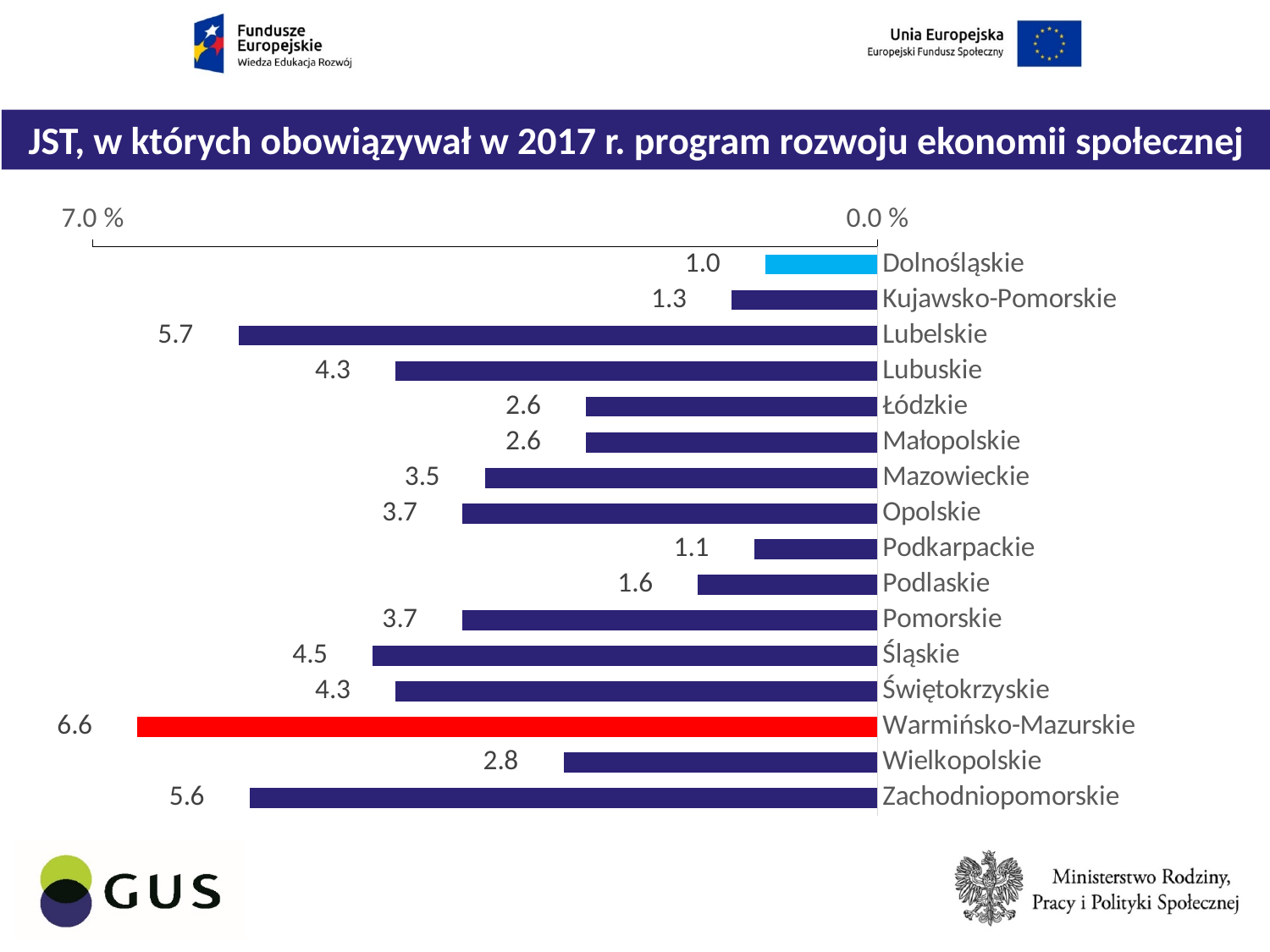
What is the difference between the values for Warmińsko-Mazurskie and Zachodniopomorskie? 1.0 What colour is the bar for Warmińsko-Mazurskie? red What is the value for Wielkopolskie? 2.8 What kind of chart is shown on the slide? bar chart What is the value for Podkarpackie? 1.1 What is the value for Lubelskie? 5.7 Which is larger, the value for Opolskie or the value for Mazowieckie? Opolskie Which voivodeship has the lowest value? Dolnośląskie What is the maximum value shown on the chart's axis? 7.0 % Which voivodeship has the highest value? Warmińsko-Mazurskie How many voivodeships are shown in the chart? 16 What is the difference between the values for Śląskie and Podlaskie? 2.9